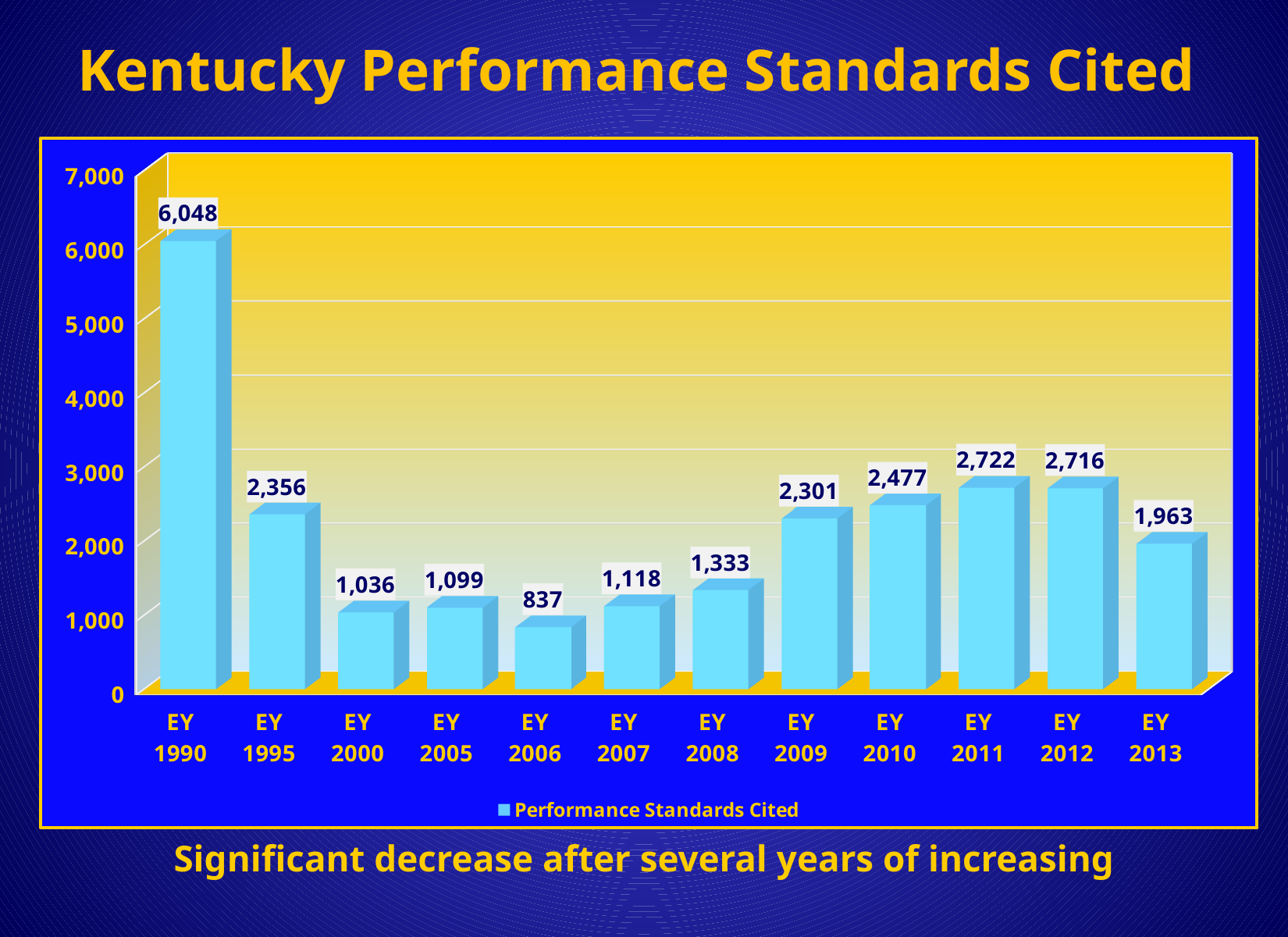
Do the values rise or fall from EY 2006 to EY 2011? rise Is the value for EY 1995 greater or less than 2,000? greater What is the value for EY 2013? 1,963 How many series does the legend list? 1 Which year has the lowest value? EY 2006 What is the value for EY 2006? 837 What kind of chart is shown? bar chart Which is larger, the value for EY 2009 or the value for EY 2010? EY 2010 What is the value for EY 1990? 6,048 Which year has the highest value? EY 1990 How many years are shown on the x axis? 12 What is the difference between the values for EY 2011 and EY 2013? 759